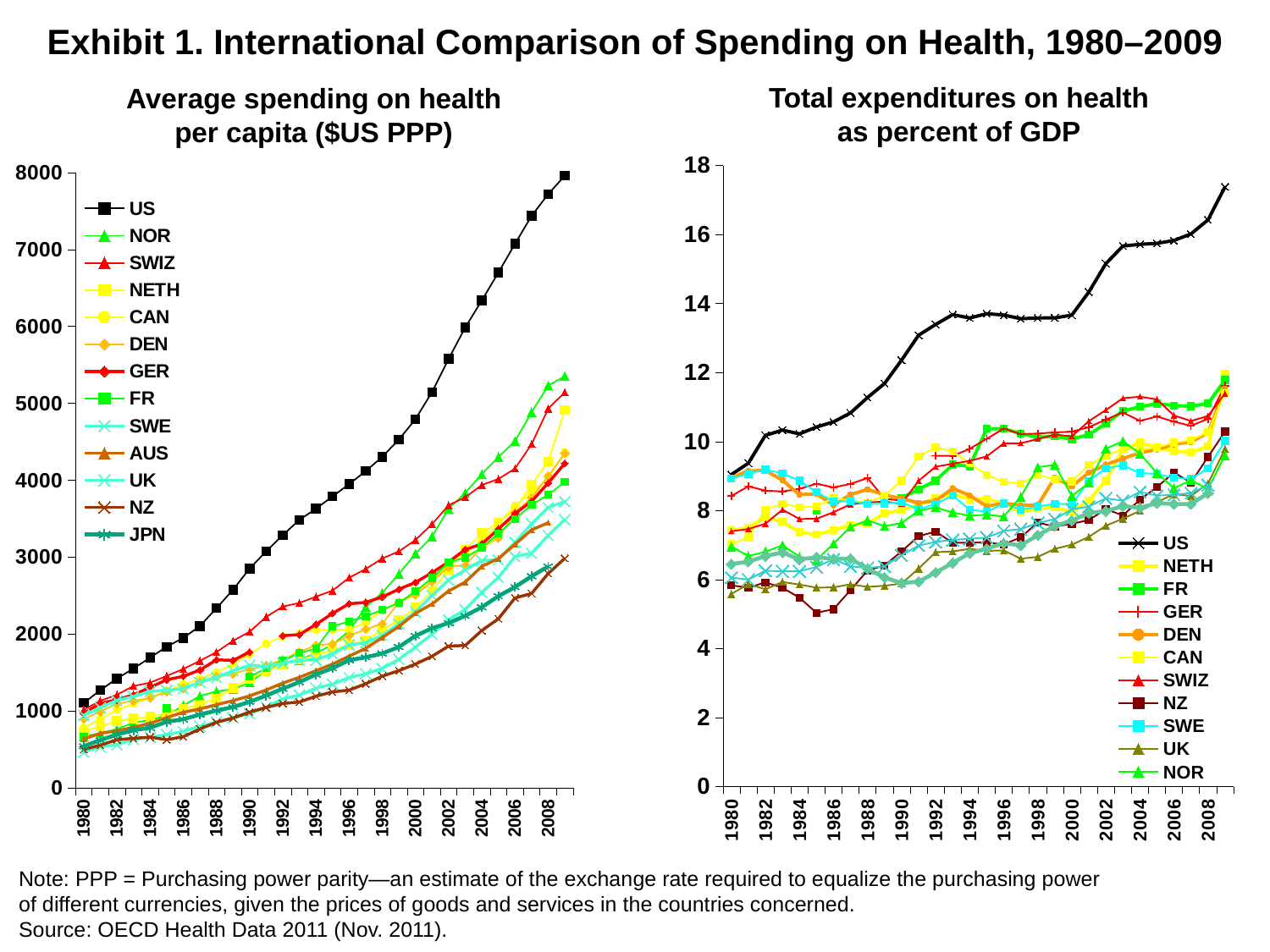
In the right chart, 'Total expenditures on health as percent of GDP', is the value for NZ in 1985 greater or less than 6? less What kind of chart is the right chart, 'Total expenditures on health as percent of GDP'? line chart In the left chart, 'Average spending on health per capita ($US PPP)', does the US series rise or fall from 1980 to 2009? rise What kind of chart is the left chart, 'Average spending on health per capita ($US PPP)'? line chart In the right chart, 'Total expenditures on health as percent of GDP', which country has the highest value in 2009? US How many series does the legend of the left chart, 'Average spending on health per capita ($US PPP)', list? 13 In the left chart, 'Average spending on health per capita ($US PPP)', is the value for US in 2009 greater or less than 7000? greater In the right chart, 'Total expenditures on health as percent of GDP', is the value for US in 2009 greater or less than 16? greater What is the title of the right chart? Total expenditures on health as percent of GDP In the left chart, 'Average spending on health per capita ($US PPP)', which country has the highest value in 2009? US How many series does the legend of the right chart, 'Total expenditures on health as percent of GDP', list? 11 In the left chart, 'Average spending on health per capita ($US PPP)', which is larger in 2009, US or NOR? US